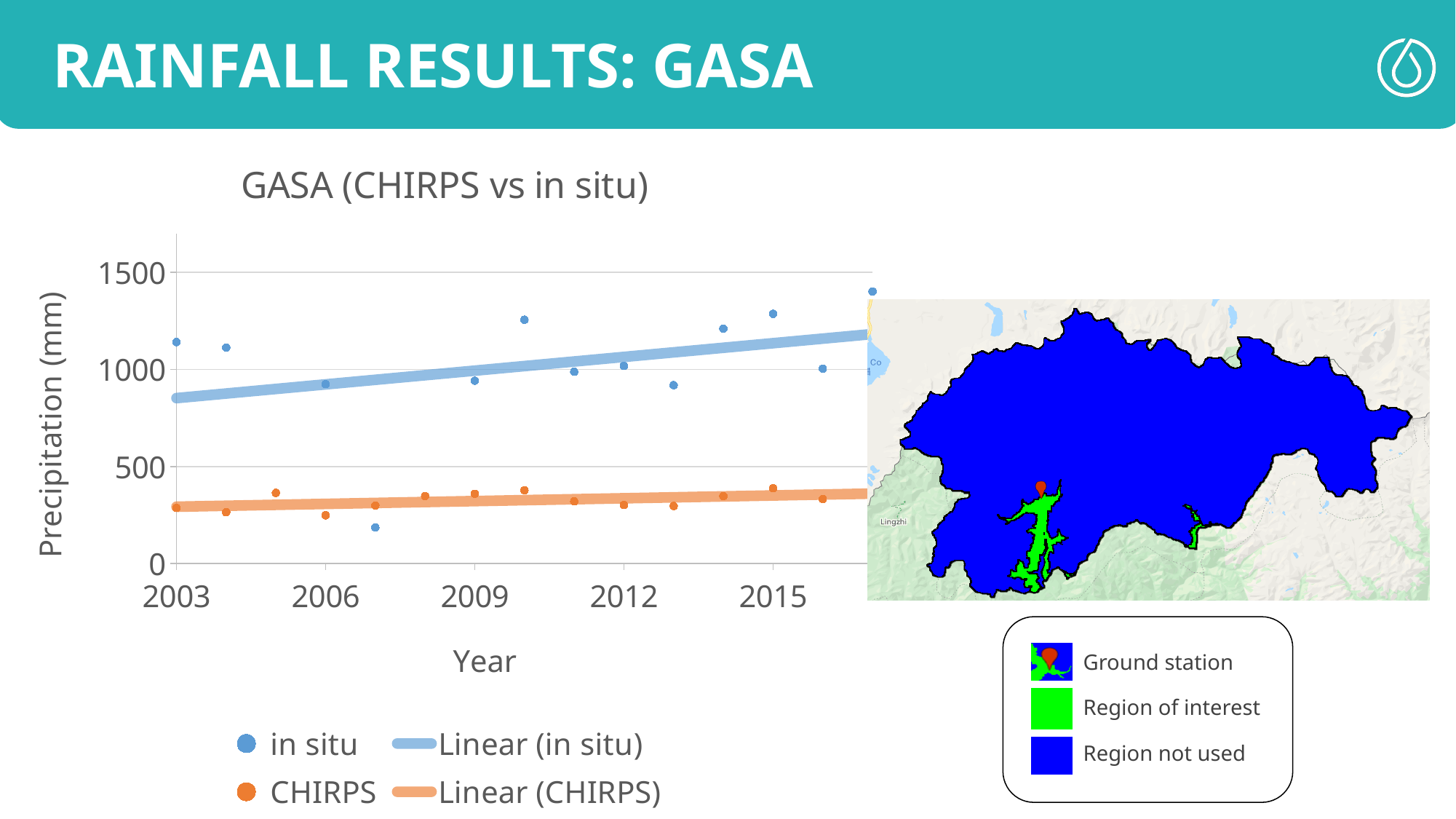
Which is larger in 2003, the in situ value or the CHIRPS value? in situ Is the in situ value for 2007 greater or less than 500? less What is the label of the vertical axis of the chart? Precipitation (mm) Is the CHIRPS value for 2003 greater or less than 500? less How many entries does the chart legend list? 4 Is the CHIRPS value for 2015 greater or less than 500? less In which year is the lowest in situ value plotted? 2007 What kind of chart is shown on the slide? Scatter chart What is the title of the chart? GASA (CHIRPS vs in situ) Does the Linear (in situ) trendline rise or fall from 2003 to the right end of the chart? rise